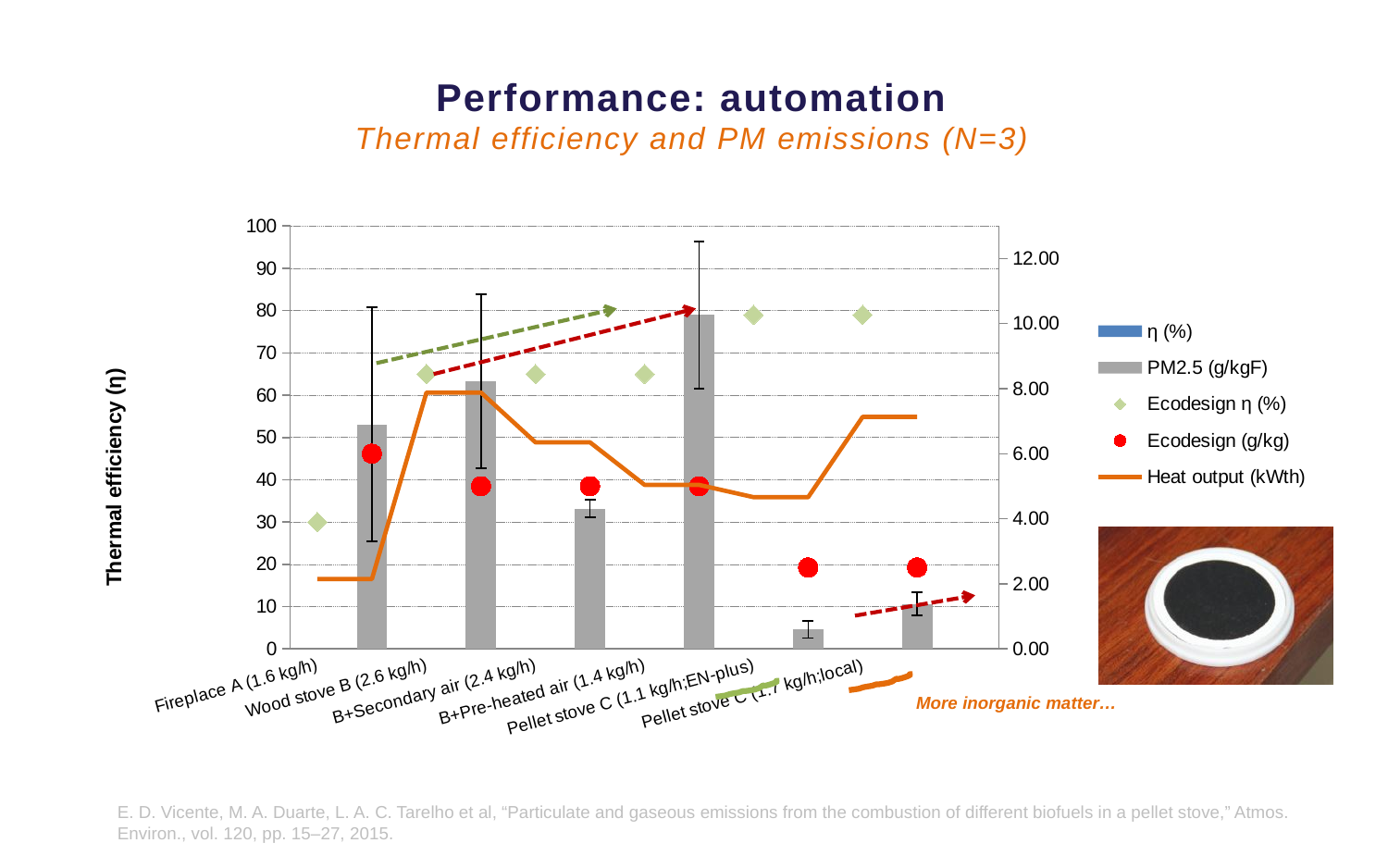
What colour is the Heat output (kWth) line in the legend? Orange What kind of chart is shown on the slide? Combined bar and line chart Which category has the lowest Ecodesign η (%) marker? Fireplace A (1.6 kg/h) How many categories are shown on the x axis of the chart? 6 How many series does the chart legend list? 5 Which category has the highest Heat output (kWth) value on the orange line? Wood stove B (2.6 kg/h)